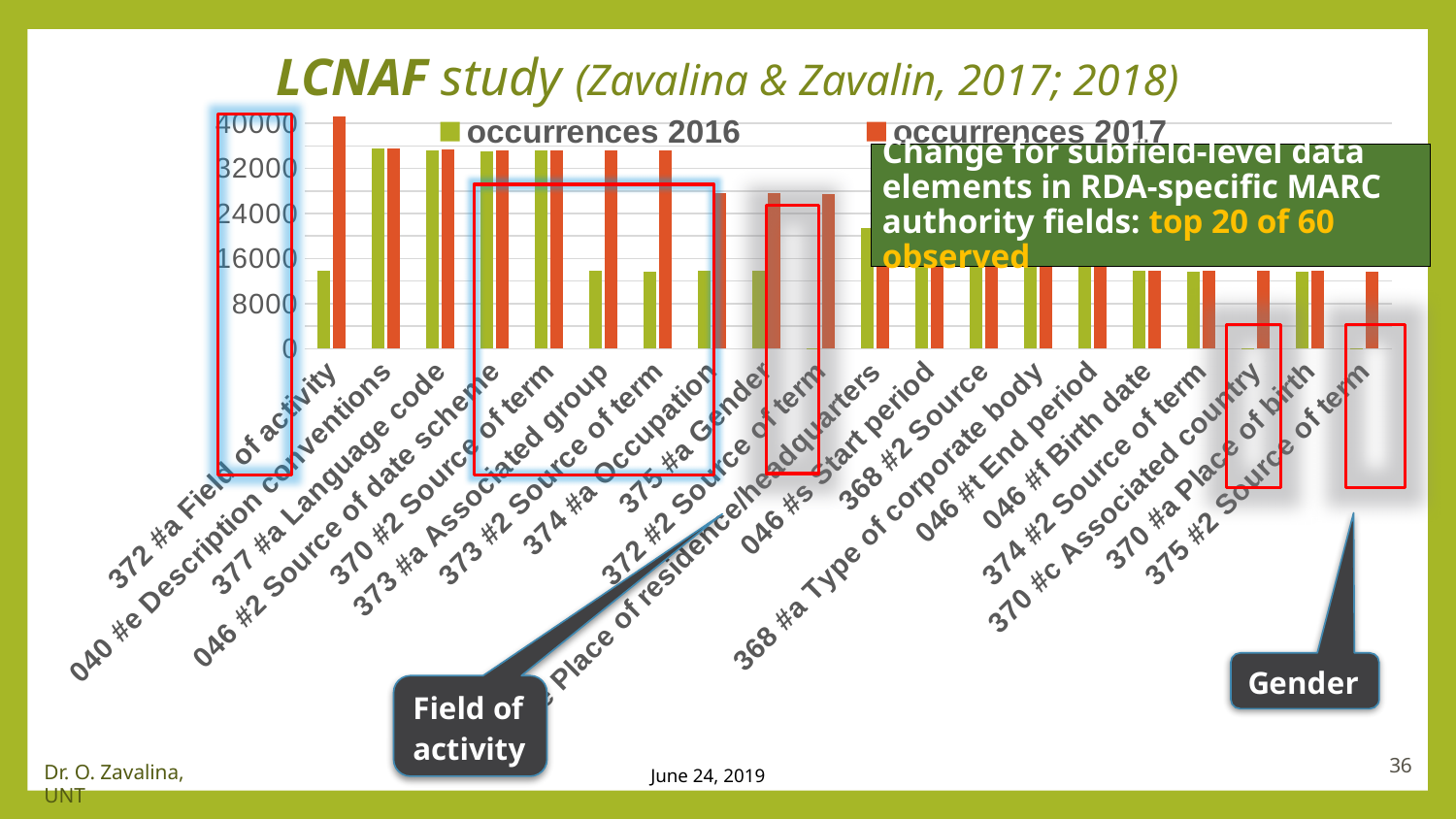
For 372 #a Field of activity, which series has the larger value, occurrences 2016 or occurrences 2017? occurrences 2017 Which category has the highest occurrences 2017 value? 372 #a Field of activity Which has the larger occurrences 2016 value, 377 #a Language code or 374 #a Occupation? 377 #a Language code How many categories (MARC subfields) are plotted on the x axis? 20 How many series does the chart's legend list? 2 Is the occurrences 2017 value for 372 #a Field of activity greater or less than 32000? greater What kind of chart is shown on the slide? bar chart Is the occurrences 2017 value for 375 #2 Source of term greater or less than 24000? less What are the two legend entries of the chart? occurrences 2016 and occurrences 2017 Is the occurrences 2016 value for 372 #a Field of activity greater or less than 24000? less Do the occurrences 2017 values generally rise or fall moving left to right along the x axis? fall